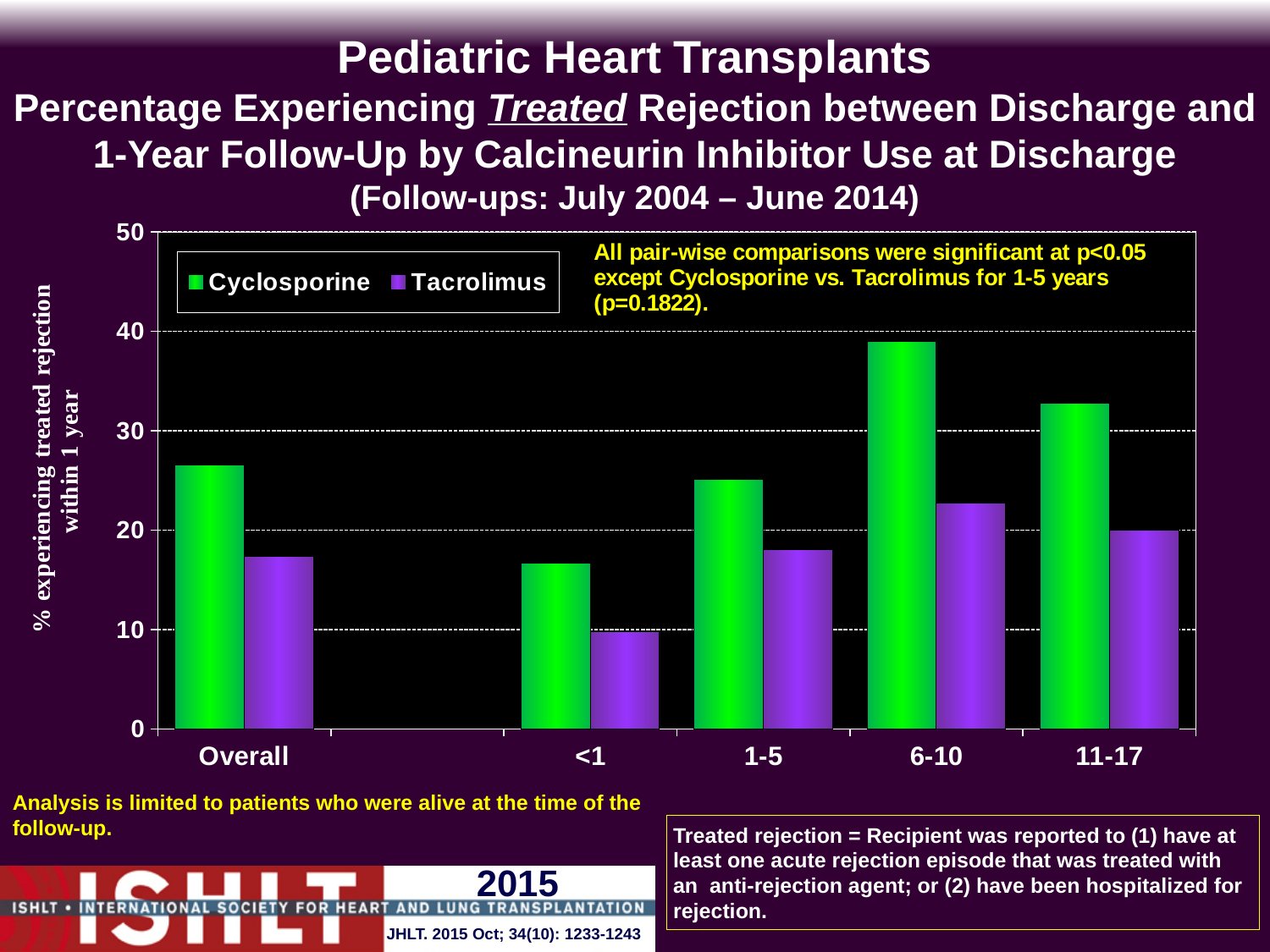
Is the Cyclosporine value for <1 greater or less than 20? less Which colour represents Cyclosporine in the legend? green Which category has the highest Tacrolimus value? 6-10 What kind of chart is shown on the slide? bar chart Is the Tacrolimus value for Overall greater or less than 20? less Which category has the highest Cyclosporine value? 6-10 How many series does the legend list? 2 Which category has the lowest Cyclosporine value? <1 For the 6-10 category, which is larger, the Cyclosporine value or the Tacrolimus value? Cyclosporine Which category has the lowest Tacrolimus value? <1 Is the Cyclosporine value for 6-10 greater or less than 30? greater How many categories are shown along the x axis? 5